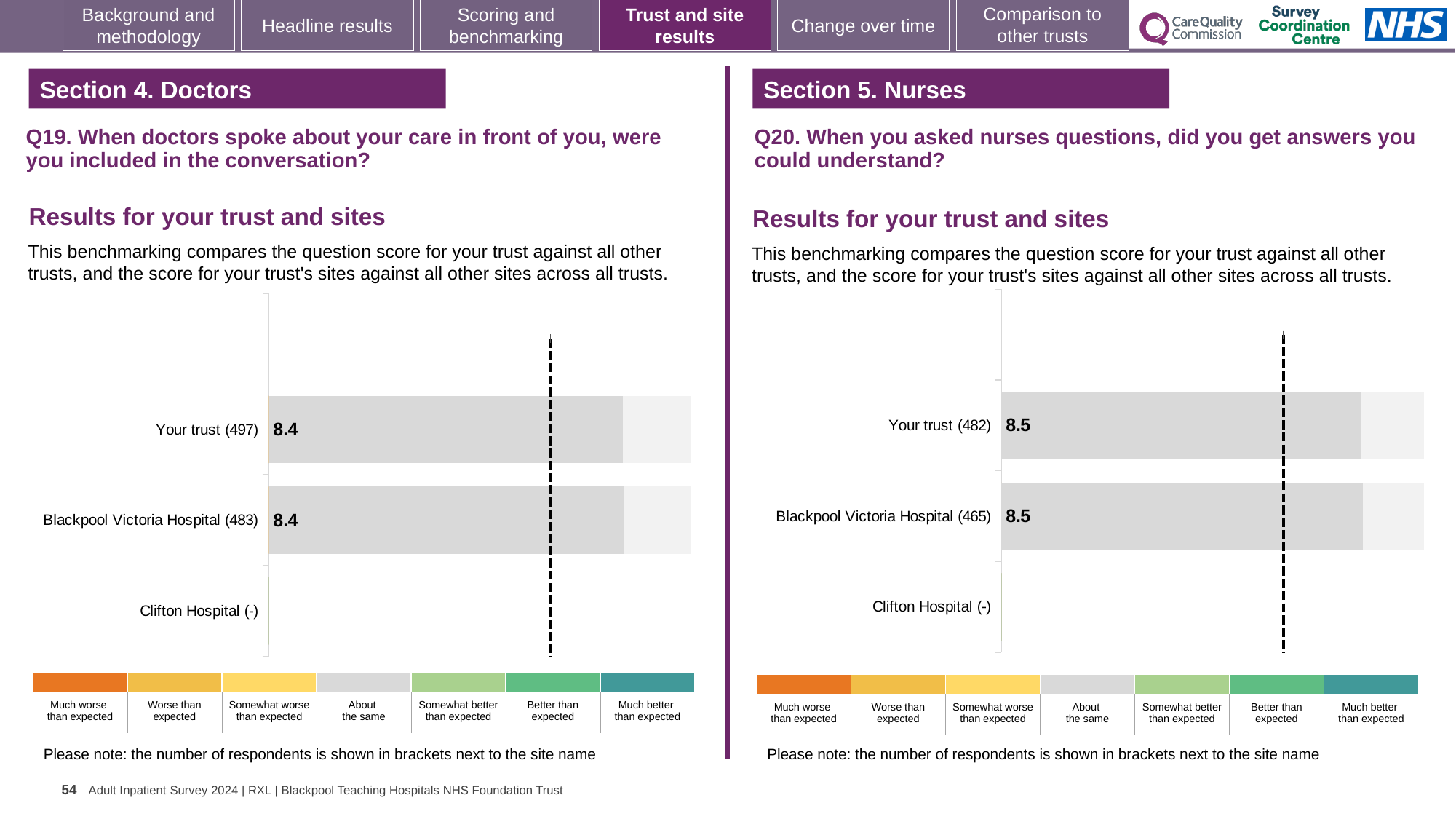
In the Q20 chart on the right, what is the difference between the scores for Your trust and Blackpool Victoria Hospital? 0 What kind of chart is used for the Q20 results on the right? Bar chart In the Q19 chart on the left, which category has no score shown? Clifton Hospital (-) In the Q19 chart on the left, what is the score for Blackpool Victoria Hospital? 8.4 In the Q20 chart on the right, how many respondents are shown in brackets for Your trust? 482 In the Q19 chart on the left, how many respondents are shown in brackets for Your trust? 497 In the Q20 chart on the right, what is the score for Your trust? 8.5 In the Q20 chart on the right, how many respondents are shown in brackets for Blackpool Victoria Hospital? 465 How many site/trust categories are listed on the y axis of the Q19 chart on the left? 3 In the Q20 chart on the right, what is the score for Blackpool Victoria Hospital? 8.5 In the Q19 chart on the left, what is the score for Your trust? 8.4 In the Q19 chart on the left, what is the difference between the scores for Your trust and Blackpool Victoria Hospital? 0